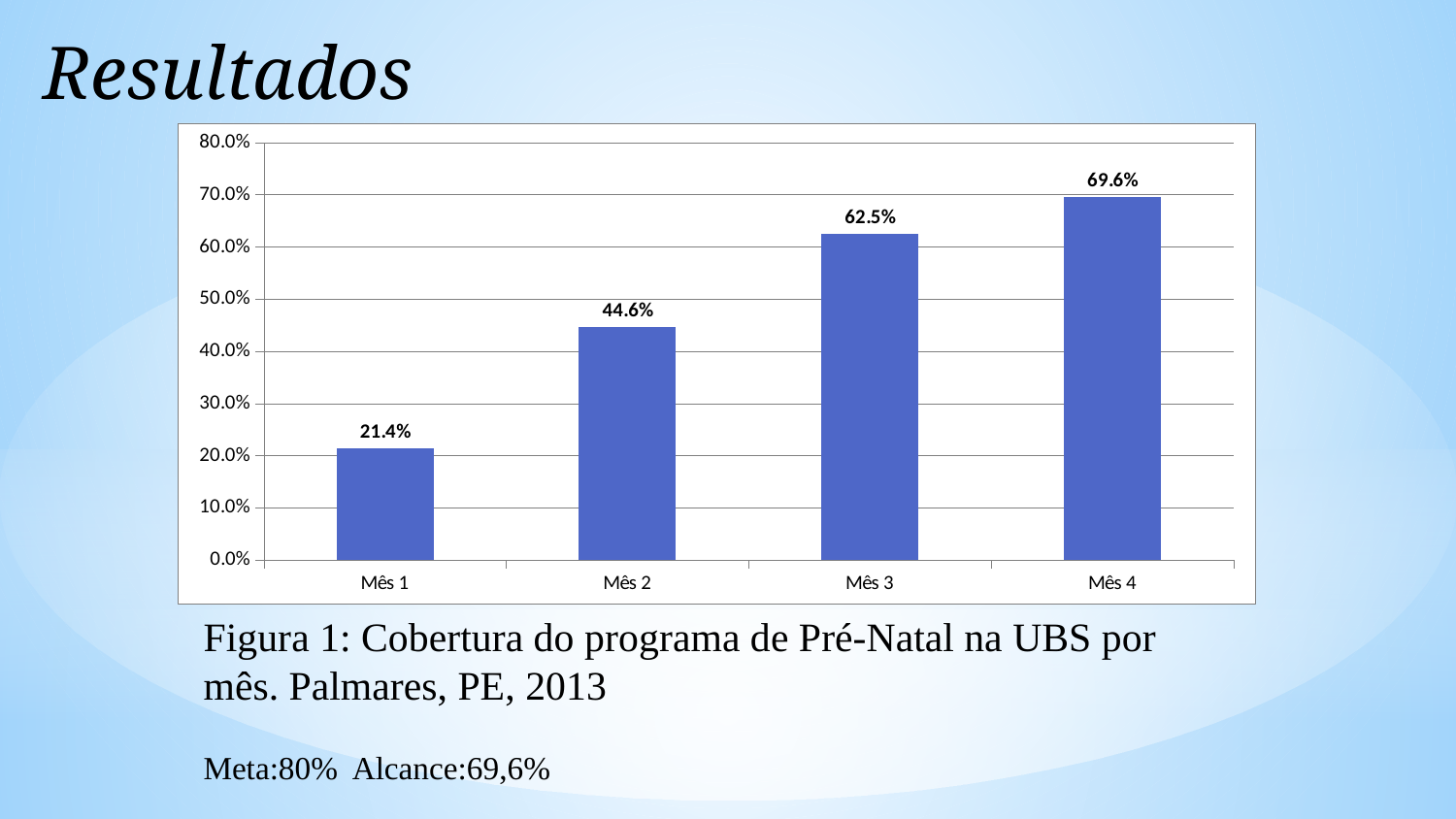
What is the difference between the values for Mês 3 and Mês 2? 17.9% What is the value for Mês 4? 69.6% What is the value for Mês 3? 62.5% What kind of chart is shown on the slide? Bar chart Which is larger, the value for Mês 2 or the value for Mês 3? Mês 3 What is the value for Mês 1? 21.4% What is the difference between the values for Mês 4 and Mês 1? 48.2% What is the value for Mês 2? 44.6% Do the values rise or fall from Mês 1 to Mês 4? Rise How many months are shown on the x axis? 4 Which month has the lowest value? Mês 1 Which month has the highest value? Mês 4